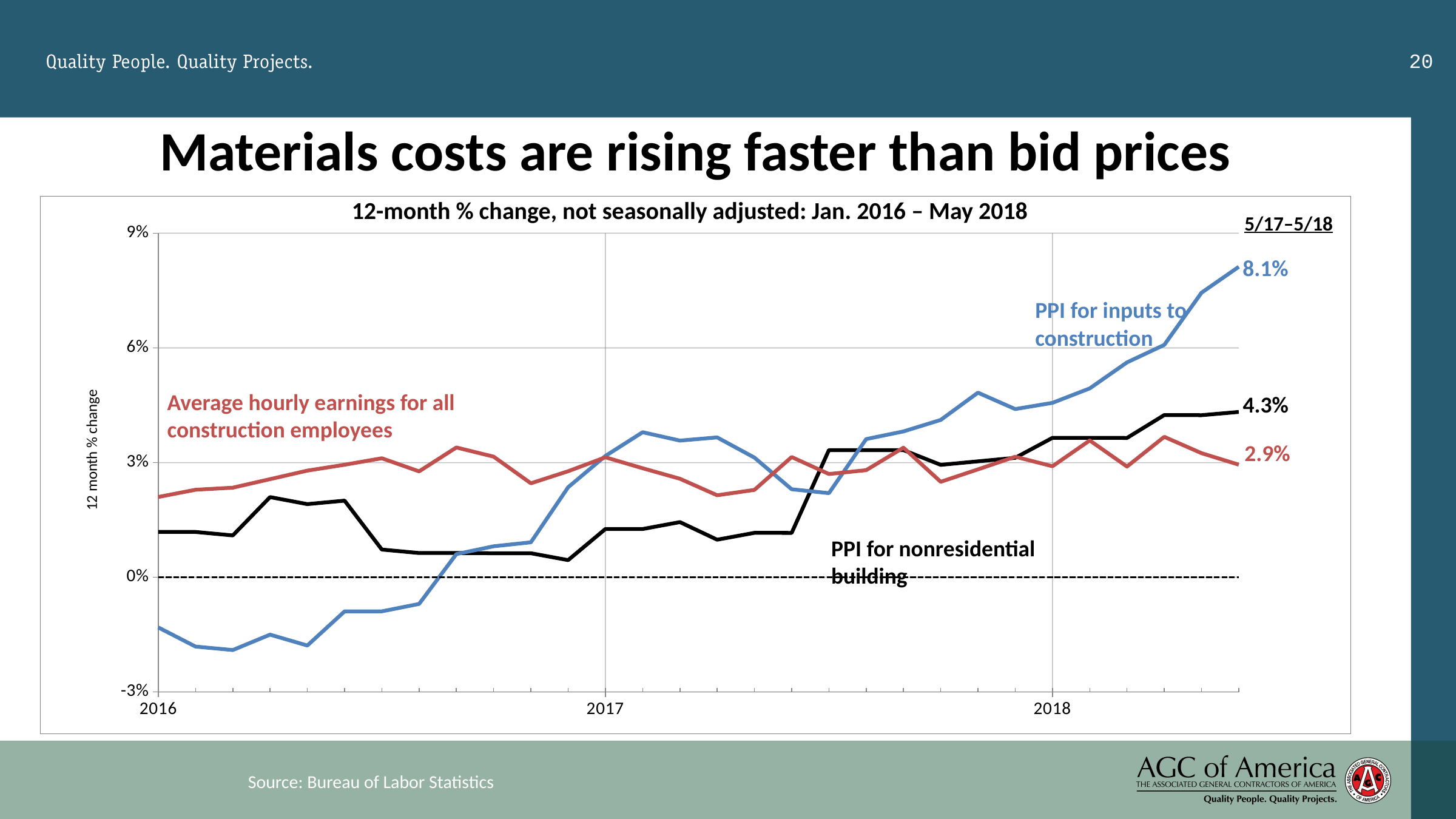
What is the difference between the 5/17–5/18 values for PPI for inputs to construction and PPI for nonresidential building? 3.8 percentage points Which series has the lowest 5/17–5/18 value? Average hourly earnings for all construction employees How many data series are plotted on the chart? 3 Does the PPI for inputs to construction line rise or fall from the start of 2018 to May 2018? Rise At the start of 2016, is the value for PPI for inputs to construction greater or less than 0%? less What is the 5/17–5/18 value shown for PPI for inputs to construction? 8.1% Which is larger at 5/17–5/18: PPI for nonresidential building or average hourly earnings for all construction employees? PPI for nonresidential building What is the 5/17–5/18 value shown for PPI for nonresidential building? 4.3% Which series has the highest 5/17–5/18 value? PPI for inputs to construction What is the 5/17–5/18 value shown for average hourly earnings for all construction employees? 2.9% At the start of 2016, is the value for PPI for nonresidential building greater or less than 3%? less What kind of chart is shown on the slide? Line chart